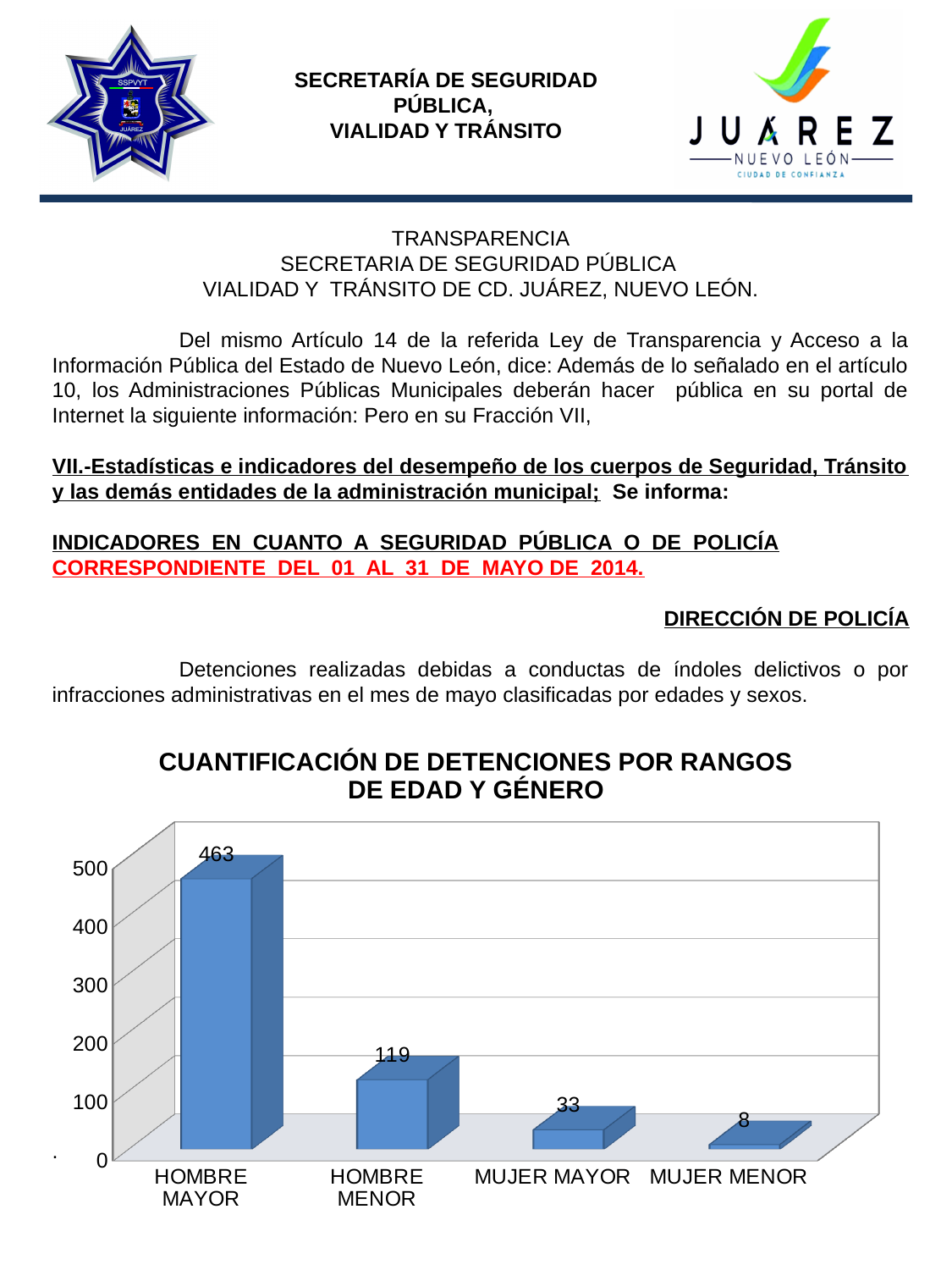
What is the value for MUJER MAYOR? 33 What is the difference between the values for MUJER MAYOR and MUJER MENOR? 25 Which category has the highest value? HOMBRE MAYOR How many categories are shown on the x axis? 4 What is the difference between the values for HOMBRE MAYOR and HOMBRE MENOR? 344 What is the value for HOMBRE MAYOR? 463 What is the value for HOMBRE MENOR? 119 What kind of chart is shown on the slide? bar chart Which category has the lowest value? MUJER MENOR What is the title of the chart? CUANTIFICACIÓN DE DETENCIONES POR RANGOS DE EDAD Y GÉNERO Which is larger, the value for HOMBRE MENOR or the value for MUJER MAYOR? HOMBRE MENOR What is the value for MUJER MENOR? 8